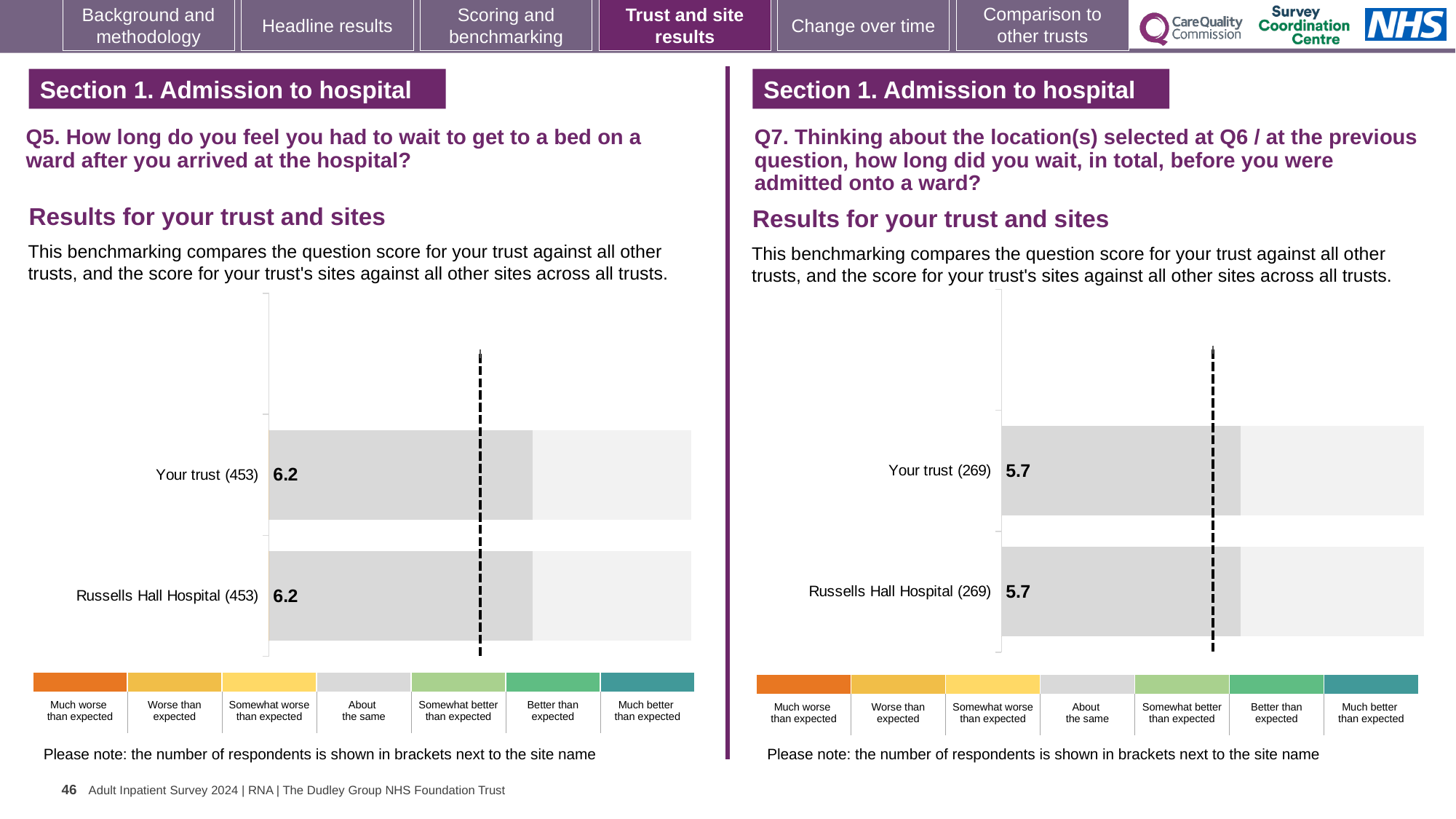
In the Q7 chart on the right, what is the score for Russells Hall Hospital? 5.7 In the Q5 chart on the left, what is the difference between the score for Your trust and the score for Russells Hall Hospital? 0 What type of chart is the Q5 chart on the left? Bar chart In the Q5 chart on the left, what is the score for Russells Hall Hospital? 6.2 How many categories does the colour key below the Q7 chart on the right list? 7 In the Q5 chart on the left, which benchmark category does the grey colour of the bars correspond to in the key? About the same In the Q5 chart on the left, how many respondents are shown in brackets for Russells Hall Hospital? 453 In the Q7 chart on the right, what is the score for Your trust? 5.7 In the Q7 chart on the right, how many bars are plotted? 2 In the Q7 chart on the right, how many respondents are shown in brackets for Your trust? 269 In the Q5 chart on the left, what is the score for Your trust? 6.2 Is the score for Your trust in the Q5 chart on the left larger than the score for Your trust in the Q7 chart on the right? Yes